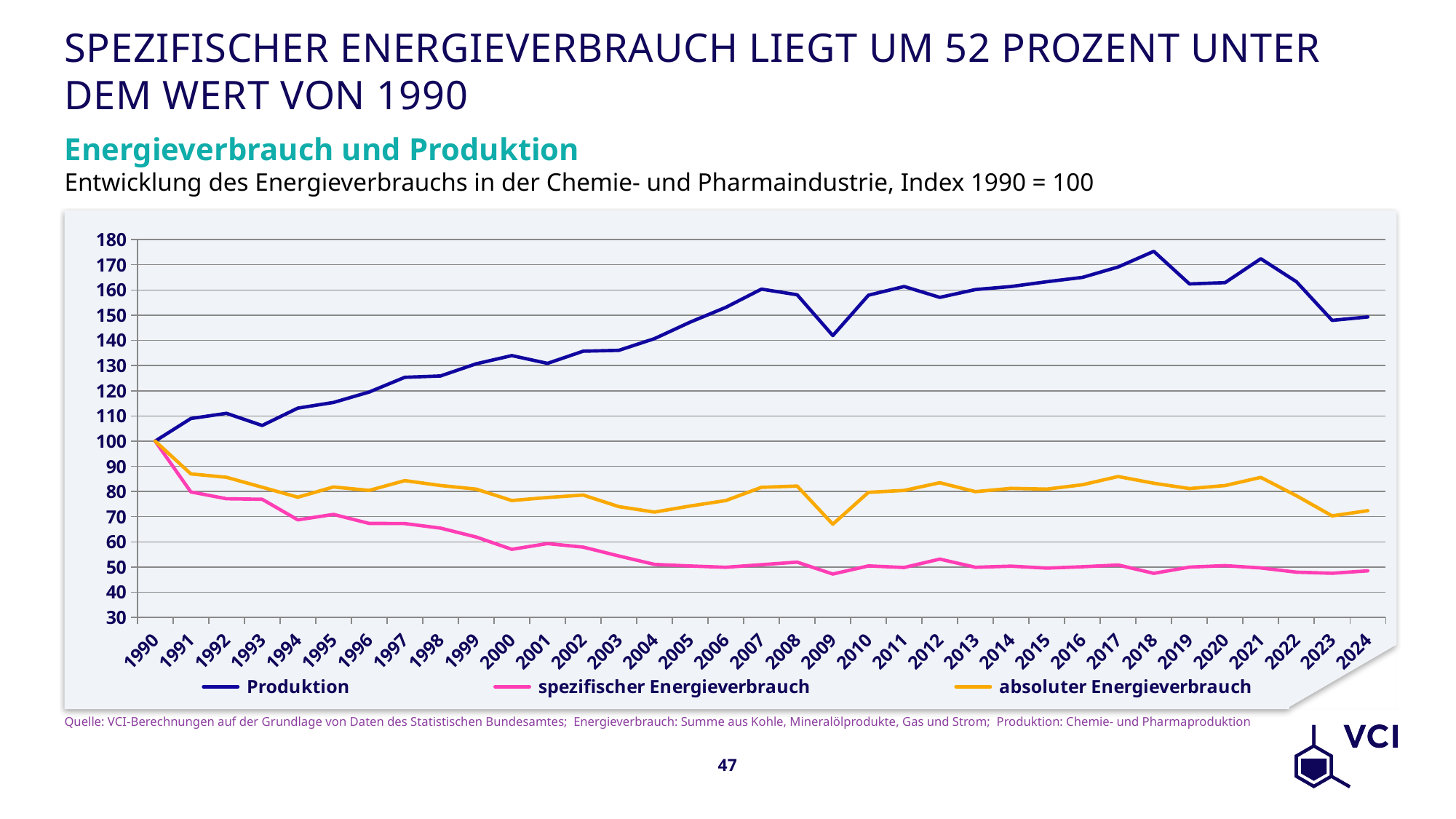
In which year does the Produktion series reach its highest value? 2018 Does the spezifischer Energieverbrauch series generally rise or fall from 1990 to 2024? fall In which year is the Produktion series at its lowest value? 1990 How many series does the legend list? 3 Is the value for Produktion in 2018 greater or less than 170? greater Is the value for Produktion in 2009 greater or less than 150? less Is the value for absoluter Energieverbrauch in 2009 greater or less than 70? less What kind of chart is shown on the slide? line chart In 2024, which is larger: Produktion or spezifischer Energieverbrauch? Produktion How many years are plotted along the x axis? 35 What is the index value of Produktion in 1990? 100